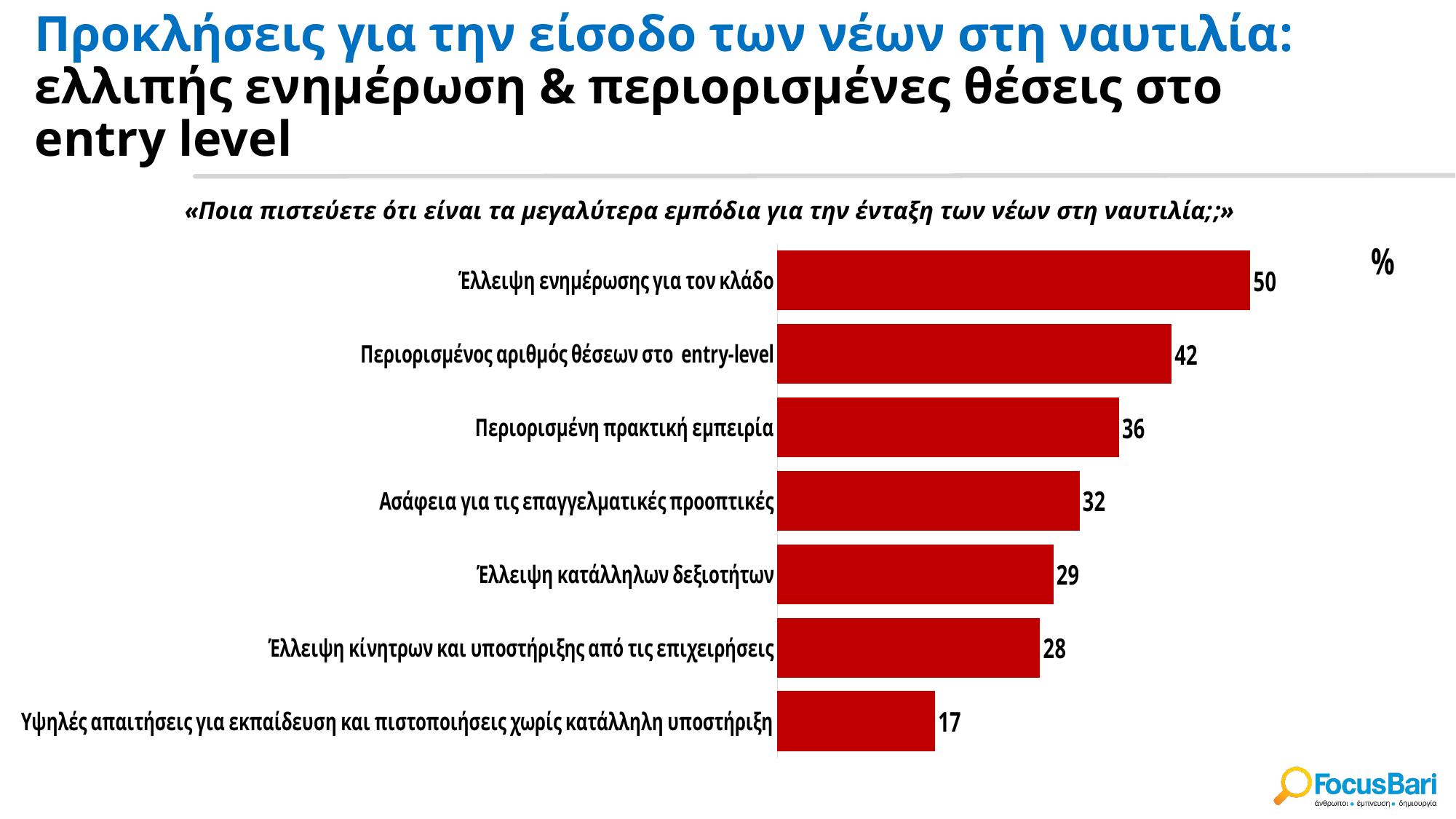
What is the difference between the values for 'Περιορισμένη πρακτική εμπειρία' and 'Έλλειψη κατάλληλων δεξιοτήτων'? 7 Which category has the lowest value? Υψηλές απαιτήσεις για εκπαίδευση και πιστοποιήσεις χωρίς κατάλληλη υποστήριξη Which category has the highest value? Έλλειψη ενημέρωσης για τον κλάδο What is the value for 'Έλλειψη ενημέρωσης για τον κλάδο'? 50 What unit is indicated at the top right of the chart? % Which is larger: the value for 'Περιορισμένη πρακτική εμπειρία' or for 'Έλλειψη κίνητρων και υποστήριξης από τις επιχειρήσεις'? Περιορισμένη πρακτική εμπειρία How many categories are shown in the chart? 7 What is the difference between the values for 'Έλλειψη ενημέρωσης για τον κλάδο' and 'Περιορισμένος αριθμός θέσεων στο entry-level'? 8 What is the value for 'Υψηλές απαιτήσεις για εκπαίδευση και πιστοποιήσεις χωρίς κατάλληλη υποστήριξη'? 17 What is the value for 'Ασάφεια για τις επαγγελματικές προοπτικές'? 32 What kind of chart is shown on the slide? Bar chart What is the value for 'Περιορισμένος αριθμός θέσεων στο entry-level'? 42